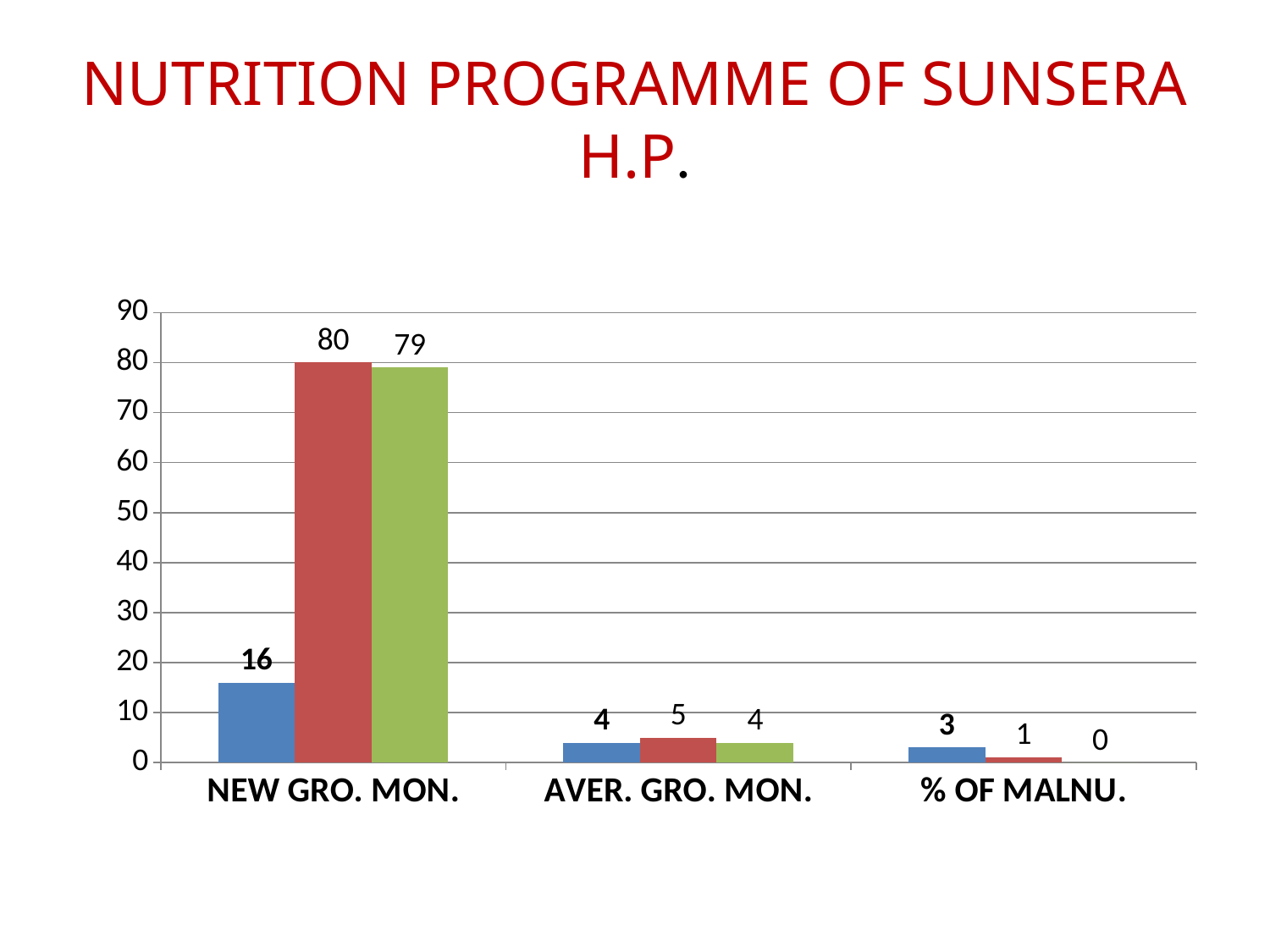
What type of chart is shown on the slide? bar chart What is the difference between the red bar and the blue bar for NEW GRO. MON.? 64 What is the value of the red bar for NEW GRO. MON.? 80 Which category has the lowest blue bar? % OF MALNU. What is the value of the green bar for NEW GRO. MON.? 79 What is the value of the blue bar for NEW GRO. MON.? 16 Which category has the highest red bar? NEW GRO. MON. What is the value of the green bar for % OF MALNU.? 0 How many bars are plotted for each category? 3 How many categories are shown on the x axis of the chart? 3 Which is larger for % OF MALNU., the blue bar or the red bar? the blue bar What is the value of the red bar for AVER. GRO. MON.? 5